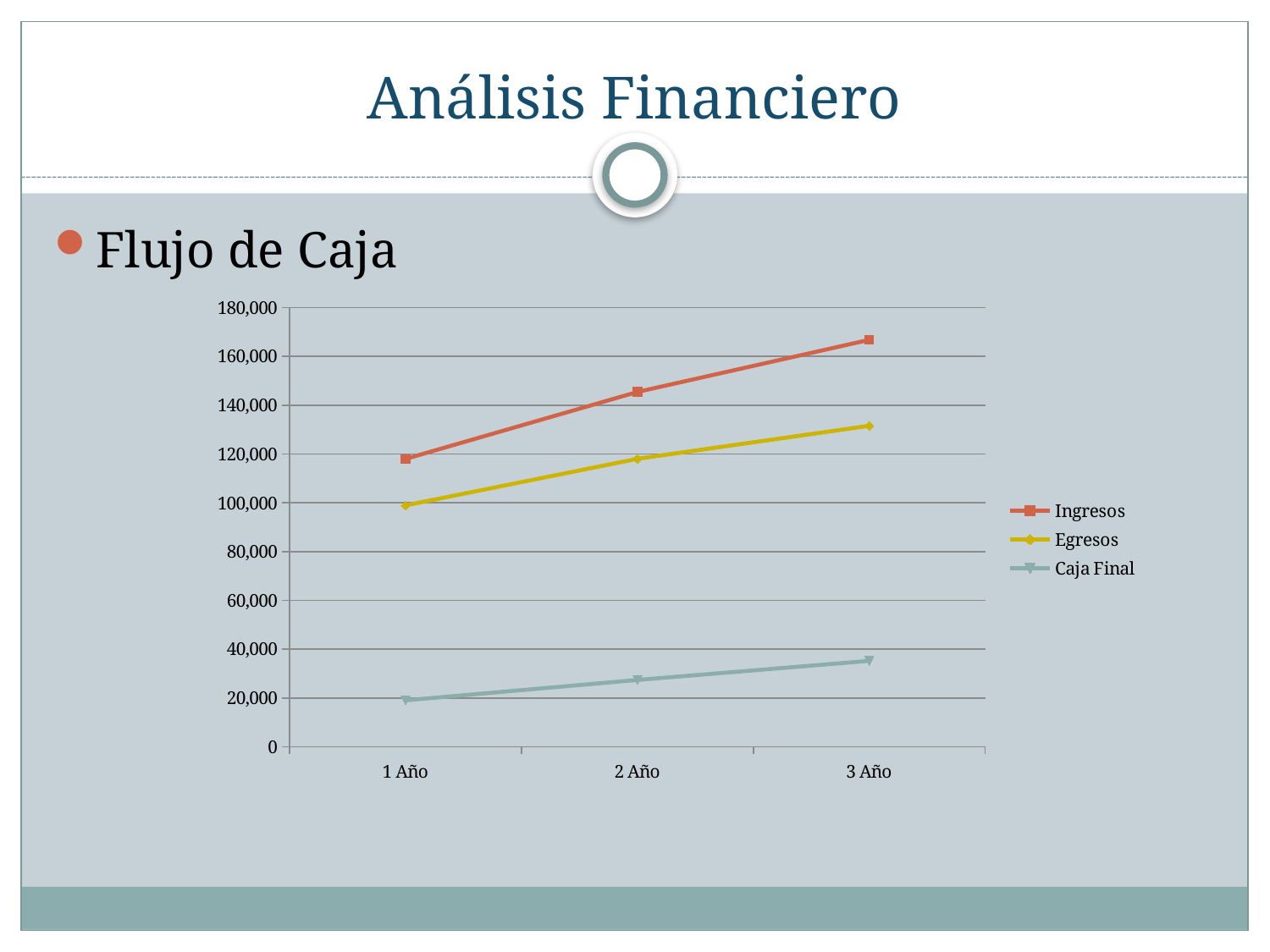
How many points along the x axis does each series have? 3 Is the value for Egresos at 3 Año greater or less than 120,000? greater What is the label of the first category on the x axis? 1 Año Do the Caja Final values rise or fall from 1 Año to 3 Año? rise Which series has the highest values across all years? Ingresos At 2 Año, which is larger, Ingresos or Egresos? Ingresos Is the value for Caja Final at 3 Año greater or less than 40,000? less Is the value for Ingresos at 3 Año greater or less than 160,000? greater Do the Ingresos values rise or fall from 1 Año to 3 Año? rise What kind of chart is shown on the slide? line chart Which series has the lowest values across all years? Caja Final How many series does the legend list? 3